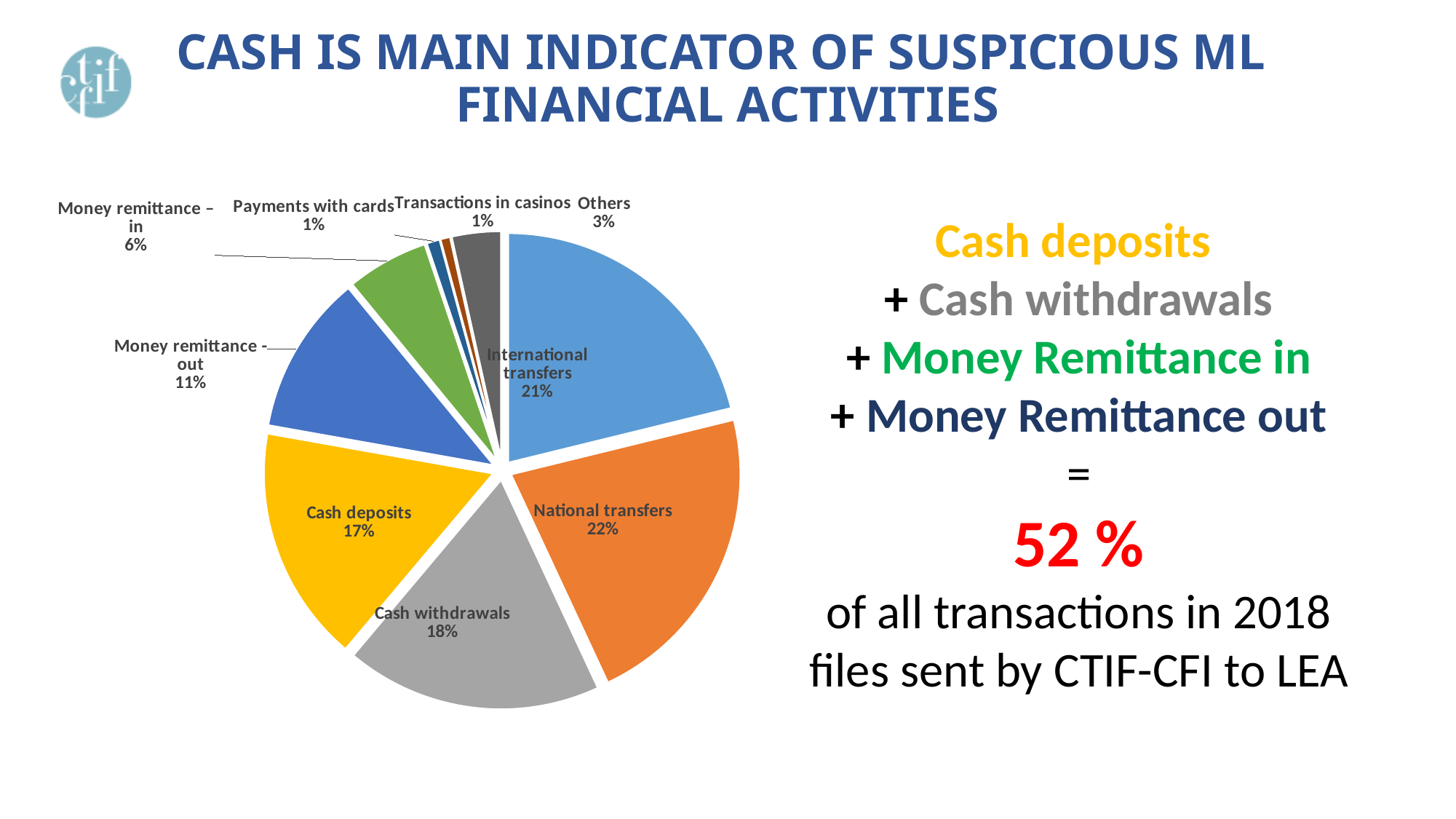
What share of the pie is Money remittance - out? 11% What share of the pie is Cash withdrawals? 18% Which is larger, the share of International transfers or the share of Money remittance - out? International transfers What share of the pie is National transfers? 22% What share of the pie is Payments with cards? 1% Which category has the largest slice of the pie? National transfers What is the difference between the shares of Cash withdrawals and Cash deposits? 1% How many slices does the pie chart have? 9 What is the difference between the shares of Money remittance - out and Money remittance – in? 5% What colour is the Cash deposits slice? yellow What share of the pie is Others? 3% What kind of chart is shown on the slide? pie chart